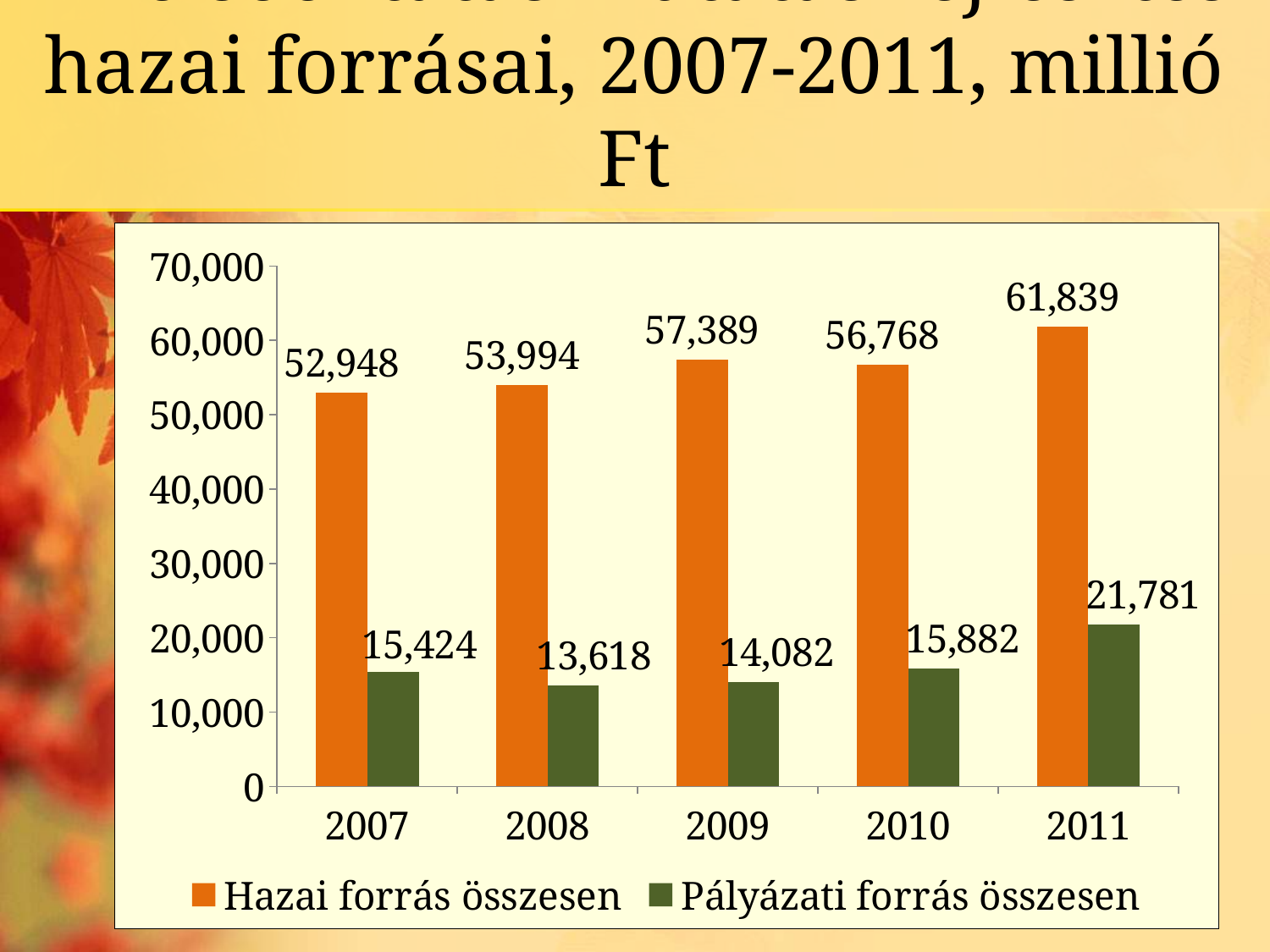
What is the value of Hazai forrás összesen for 2009? 57,389 What is the value of Hazai forrás összesen for 2011? 61,839 How many years are shown on the x axis? 5 Which year has the lowest value for Hazai forrás összesen? 2007 What is the difference between Hazai forrás összesen and Pályázati forrás összesen in 2010? 40,886 Is the value for Pályázati forrás összesen in 2011 greater or less than 20,000? greater How many series does the legend list? 2 What is the value of Pályázati forrás összesen for 2008? 13,618 Which is larger: Hazai forrás összesen in 2009 or in 2010? 2009 What colour are the bars for Pályázati forrás összesen? green What kind of chart is shown on the slide? bar chart Which year has the highest value for Pályázati forrás összesen? 2011